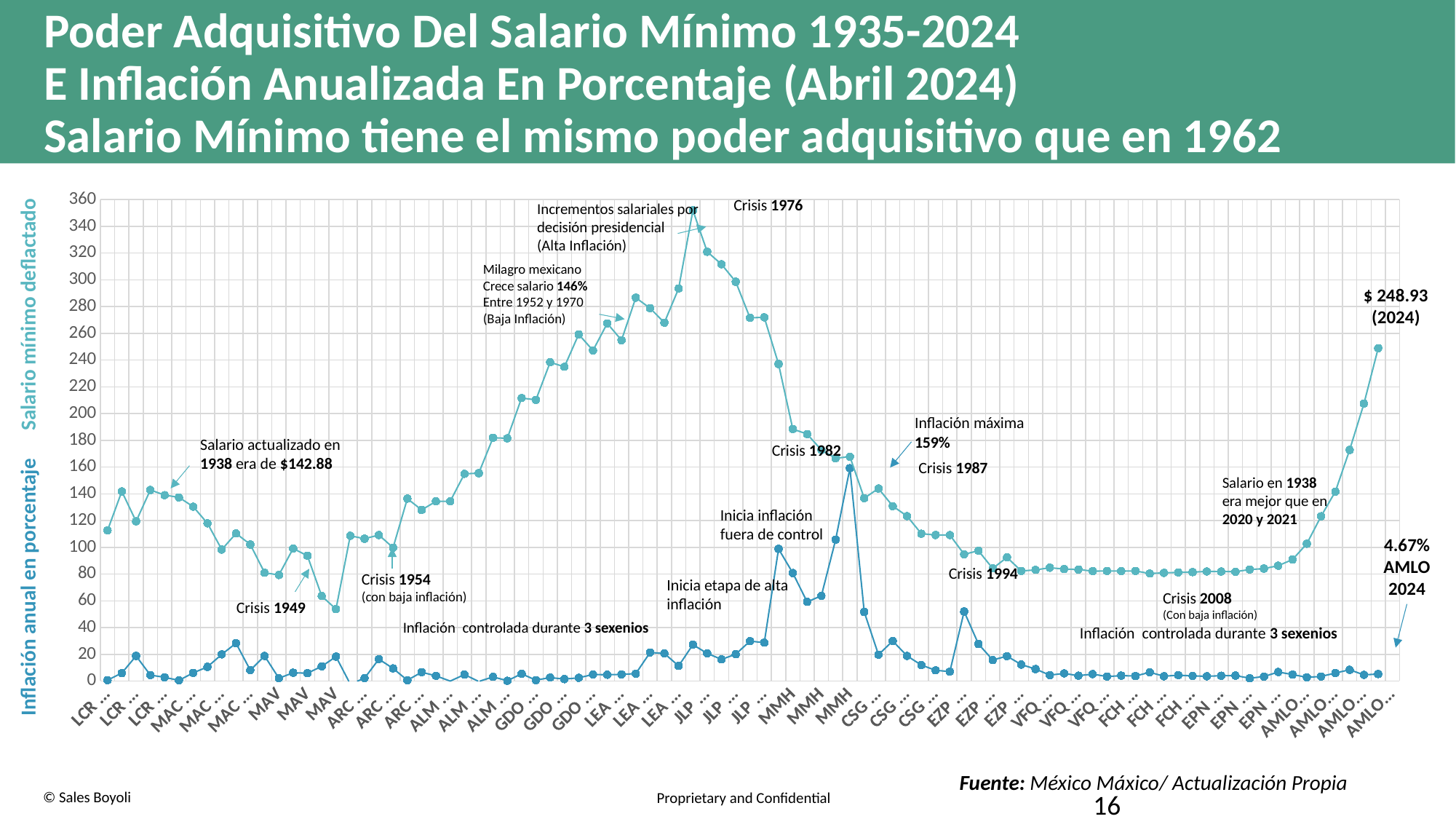
Is the peak value of the deflated minimum wage in 1976 greater or less than 340? greater What is the source cited for the chart? México Máxico/ Actualización Propia What is the difference between the deflated minimum wage in 2024 ($248.93) and the 1938 value ($142.88)? $106.05 From the 1976 peak through the 1990s, does the deflated minimum wage series rise or fall? fall According to the annotation, what was the updated minimum wage in 1938? $142.88 How many data series are plotted on the chart? 2 Which is higher: the deflated minimum wage at its 1976 peak or its 2024 value? 1976 peak According to the annotation, what is the deflated minimum wage value for 2024? $ 248.93 What is the maximum annual inflation value noted on the chart? 159% In which year does the deflated minimum wage series reach its highest point? 1976 What is the annual inflation value noted for AMLO in 2024? 4.67% What kind of chart is shown on the slide? line chart